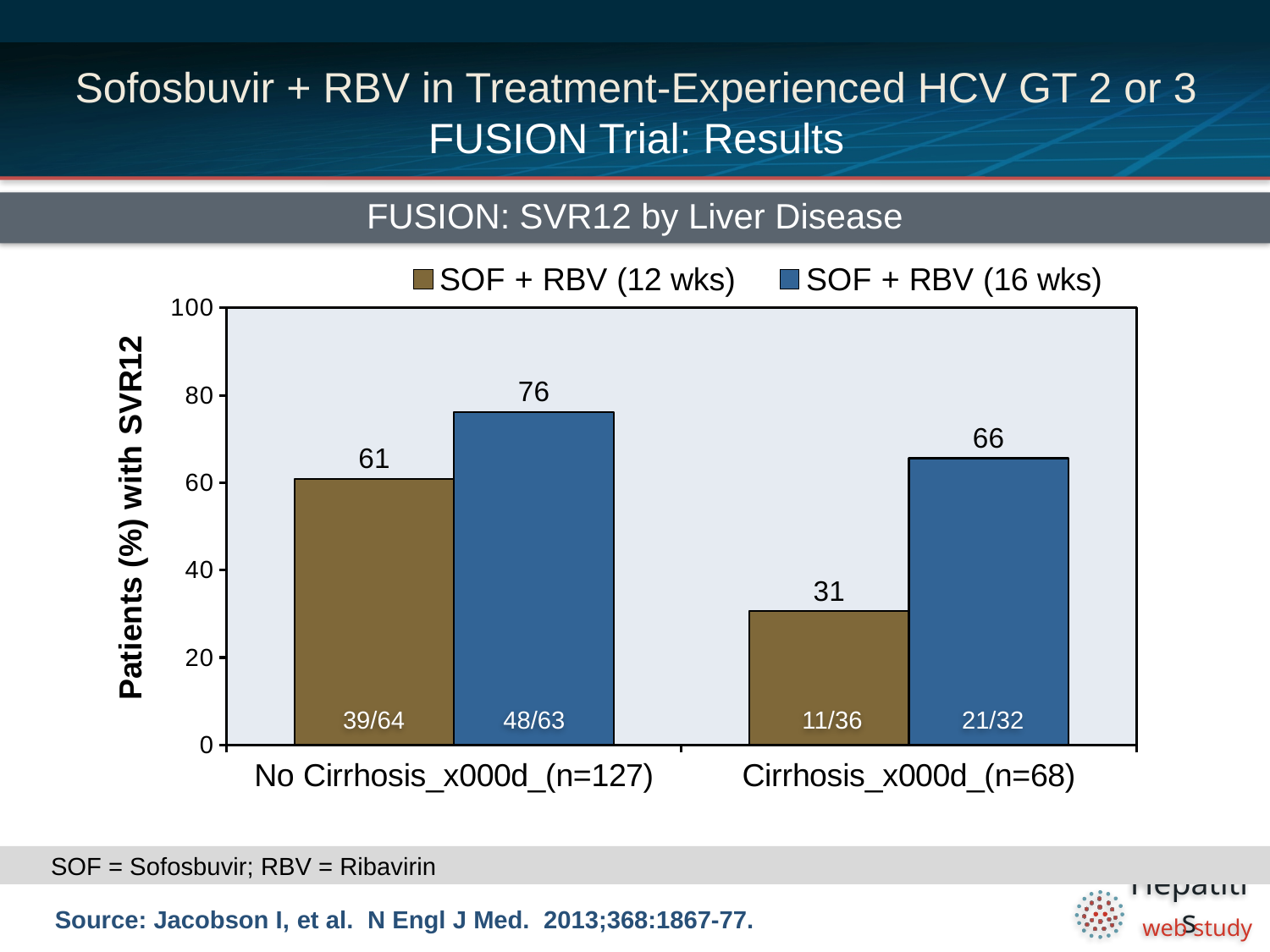
Which is larger: the SVR12 rate for SOF + RBV (16 wks) in no cirrhosis or in cirrhosis? No Cirrhosis Which bar has the lowest SVR12 rate on the chart? SOF + RBV (12 wks), Cirrhosis What is the SVR12 rate for SOF + RBV (12 wks) in patients with cirrhosis? 31 What fraction of patients is shown inside the SOF + RBV (16 wks) bar for no cirrhosis? 48/63 What is the difference in SVR12 rate between the 16-week and 12-week arms in patients with cirrhosis? 35 What is the SVR12 rate for SOF + RBV (12 wks) in patients with no cirrhosis? 61 What is the SVR12 rate for SOF + RBV (16 wks) in patients with cirrhosis? 66 What is the difference in SVR12 rate between the 16-week and 12-week arms in patients with no cirrhosis? 15 How many series does the legend list? 2 What kind of chart is shown on the slide? Bar chart How many patient categories are shown on the x axis? 2 Which bar has the highest SVR12 rate on the chart? SOF + RBV (16 wks), No Cirrhosis